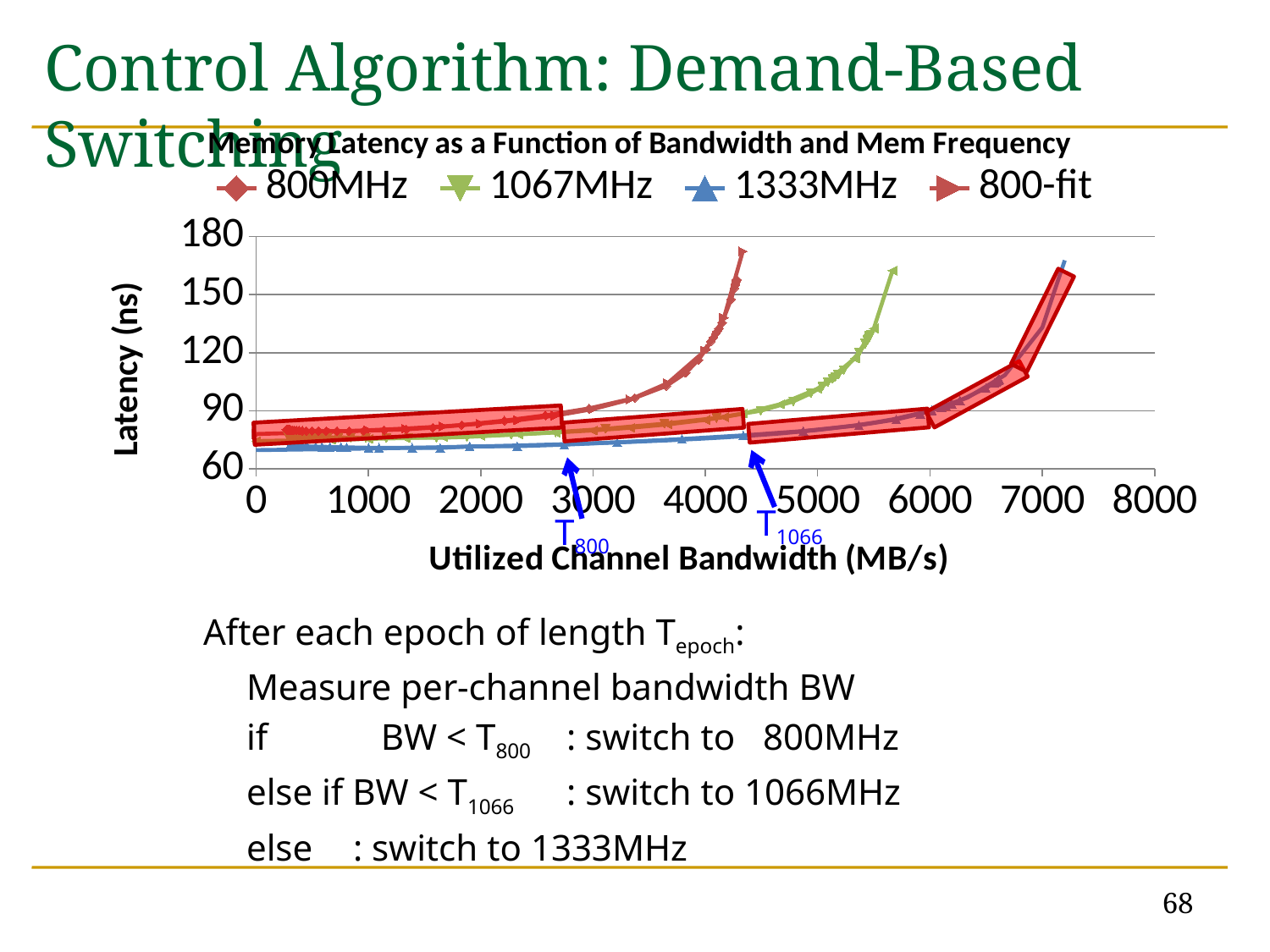
Is the latency of the 800MHz series at 3000 MB/s greater or less than 120 ns? less Which series has the lowest latency at low bandwidth (near 0 MB/s)? 1333MHz Which series reaches a higher utilized channel bandwidth before its latency spikes, 800MHz or 1333MHz? 1333MHz Is the latency of the 1067MHz series at 5000 MB/s greater or less than 120 ns? less Which series has the highest latency at 1000 MB/s, 800MHz or 1333MHz? 800MHz How many series does the chart legend list? 4 What is the title of the chart? Memory Latency as a Function of Bandwidth and Mem Frequency What kind of chart is shown on the slide? line chart What is the label of the chart's vertical axis? Latency (ns) Is the latency of the 1333MHz series at 7000 MB/s greater or less than 90 ns? greater Does the latency of the 800MHz series rise or fall as utilized channel bandwidth increases? rises